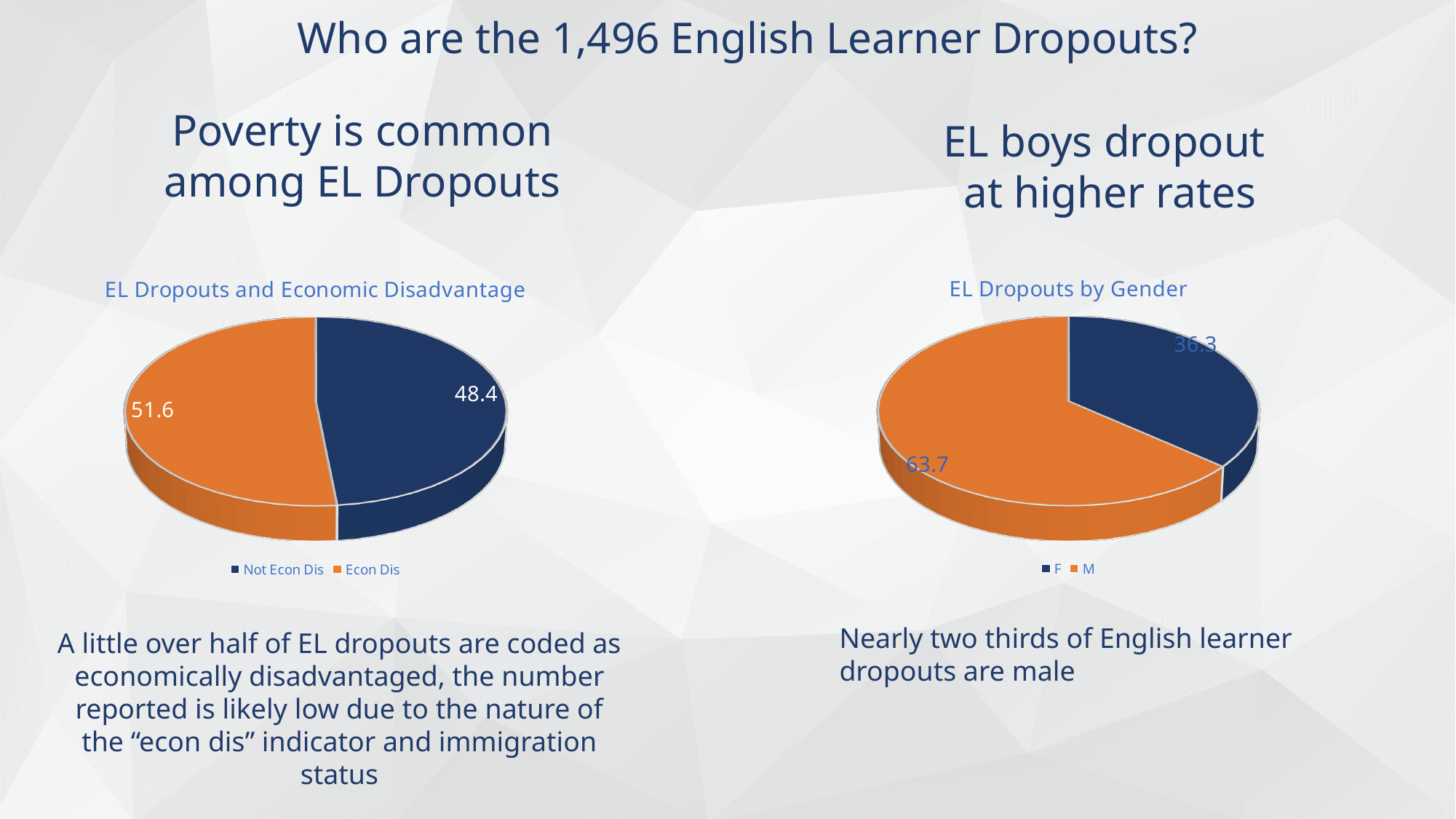
What kind of chart is 'EL Dropouts by Gender'? Pie chart In the 'EL Dropouts and Economic Disadvantage' chart, what is the value for Not Econ Dis? 48.4 In the 'EL Dropouts by Gender' chart, which category has the largest slice? M In the 'EL Dropouts by Gender' chart, what is the value for F? 36.3 In the 'EL Dropouts by Gender' chart, what is the value for M? 63.7 In the 'EL Dropouts by Gender' chart, which is larger, F or M? M How many categories does the 'EL Dropouts and Economic Disadvantage' chart show? 2 In the 'EL Dropouts by Gender' chart, what is the difference between the M and F values? 27.4 In the 'EL Dropouts and Economic Disadvantage' chart, what is the difference between the Econ Dis and Not Econ Dis values? 3.2 In the 'EL Dropouts and Economic Disadvantage' chart, what is the value for Econ Dis? 51.6 In the 'EL Dropouts and Economic Disadvantage' chart, which category has the smaller slice? Not Econ Dis In the 'EL Dropouts by Gender' chart, what colour is the M slice? Orange